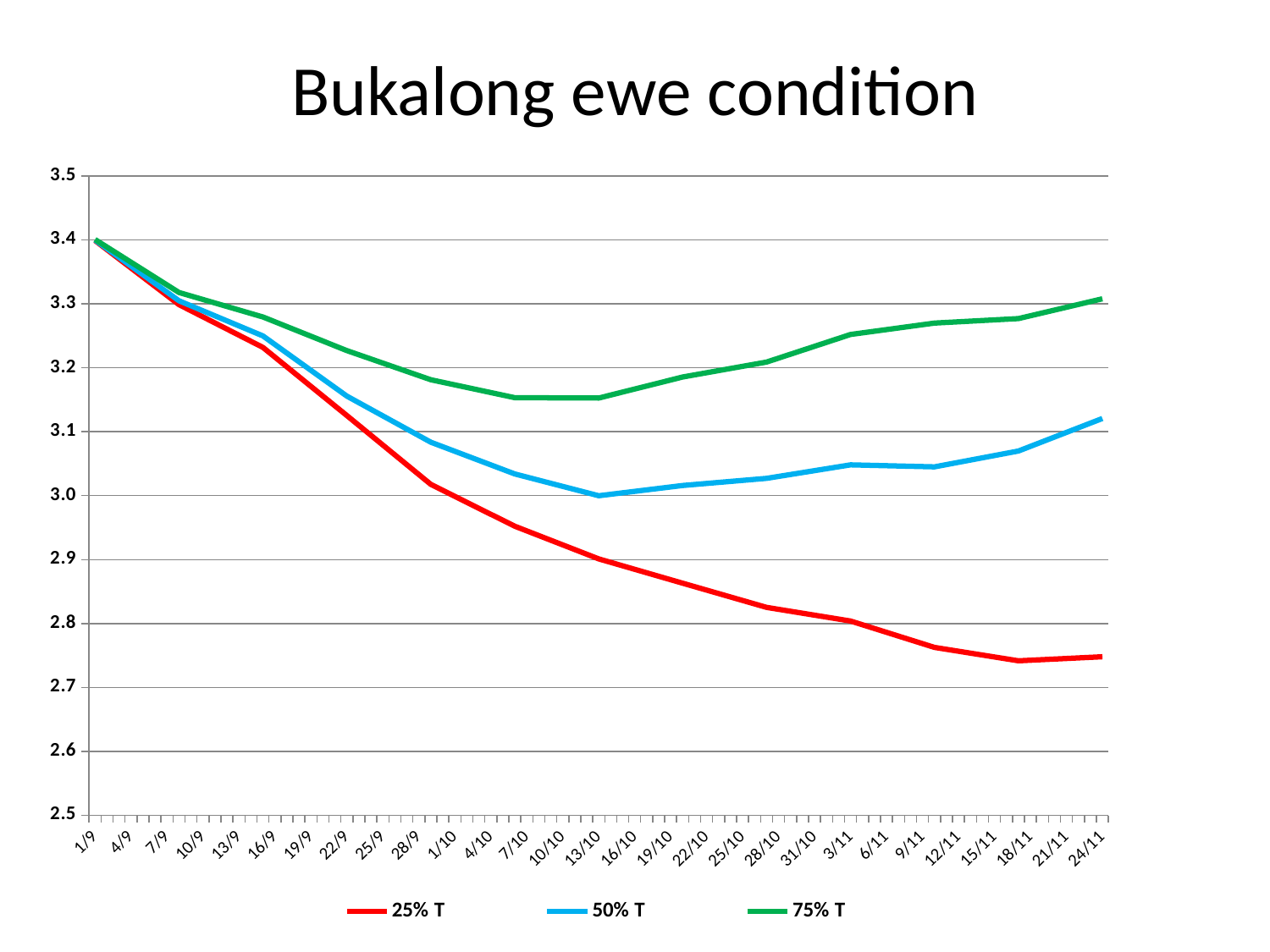
How many series does the legend list? 3 What kind of chart is shown on the slide? line chart Which series has the highest value at 7/10? 75% T Is the value for 75% T at 24/11 greater or less than 3.2? greater Is the value for 25% T at 24/11 greater or less than 2.8? less Does the 25% T series generally rise or fall from 1/9 to 24/11? fall Is the value for 75% T at 7/10 greater or less than 3.1? greater Which series has the lowest value at 18/11? 25% T What is the title of the chart? Bukalong ewe condition At 24/11, which series has the higher value, 75% T or 25% T? 75% T Which colour is used for the 25% T series? red